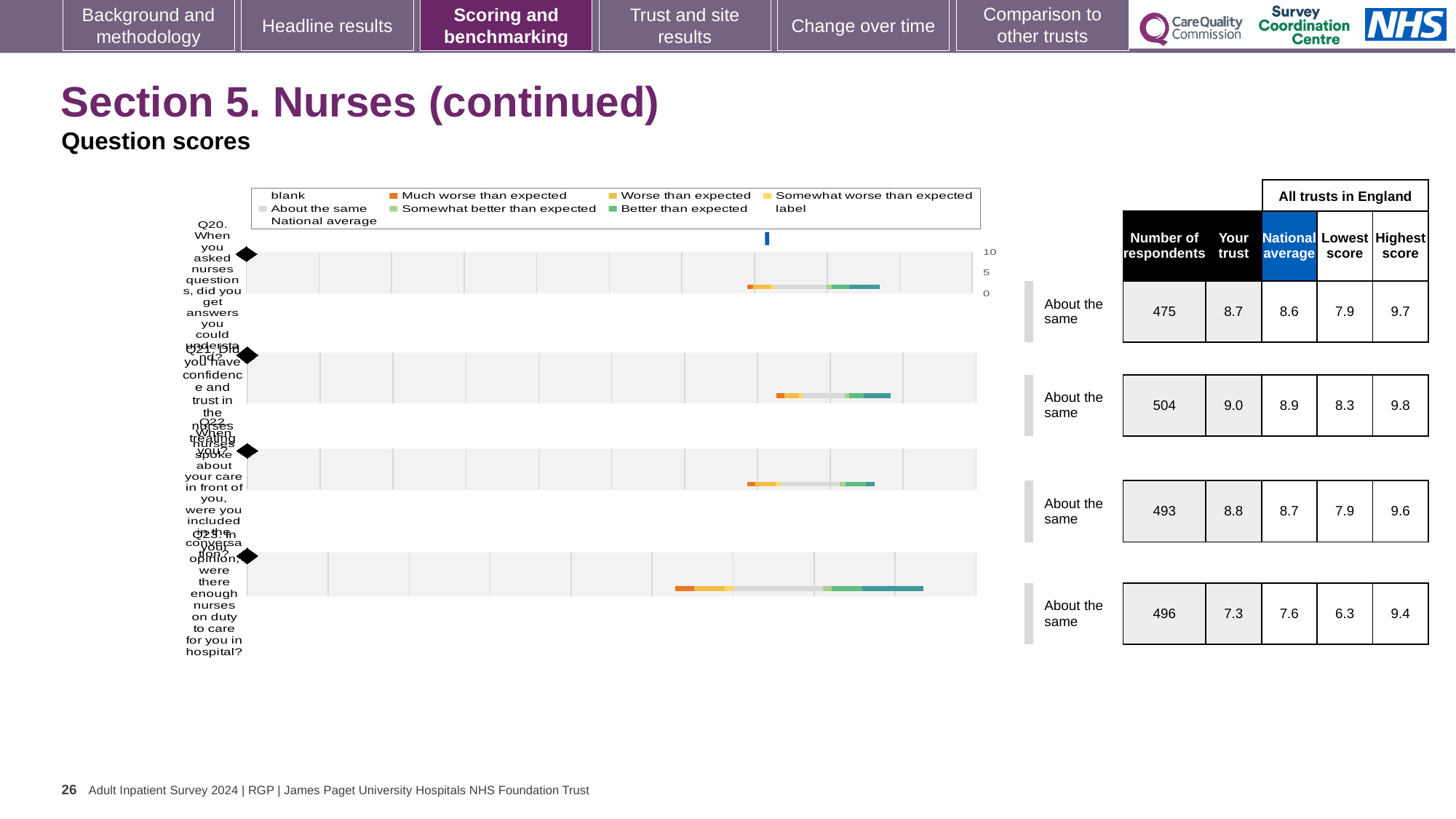
What is the number of respondents for Q23 (were there enough nurses on duty to care for you in hospital)? 496 Which question has the highest 'Your trust' score on this slide? Q21 What benchmark category is shown next to each of the four question charts? About the same How many questions (Q20 to Q23) have a chart row on this slide? 4 Which question has the lowest 'Your trust' score on this slide? Q23 What kind of chart is used to show the question scores on this slide? bar chart For Q23, what is the difference between the highest score and the lowest score among all trusts in England? 3.1 Is the 'Your trust' score for Q23 greater or less than 5 on the chart axis? greater For Q22, which is larger: the 'Your trust' score or the national average? Your trust What is the 'Your trust' score for Q20 (when you asked nurses questions, did you get answers you could understand)? 8.7 What is the highest score among all trusts in England for Q22? 9.6 What is the national average score for Q21 (did you have confidence and trust in the nurses treating you)? 8.9